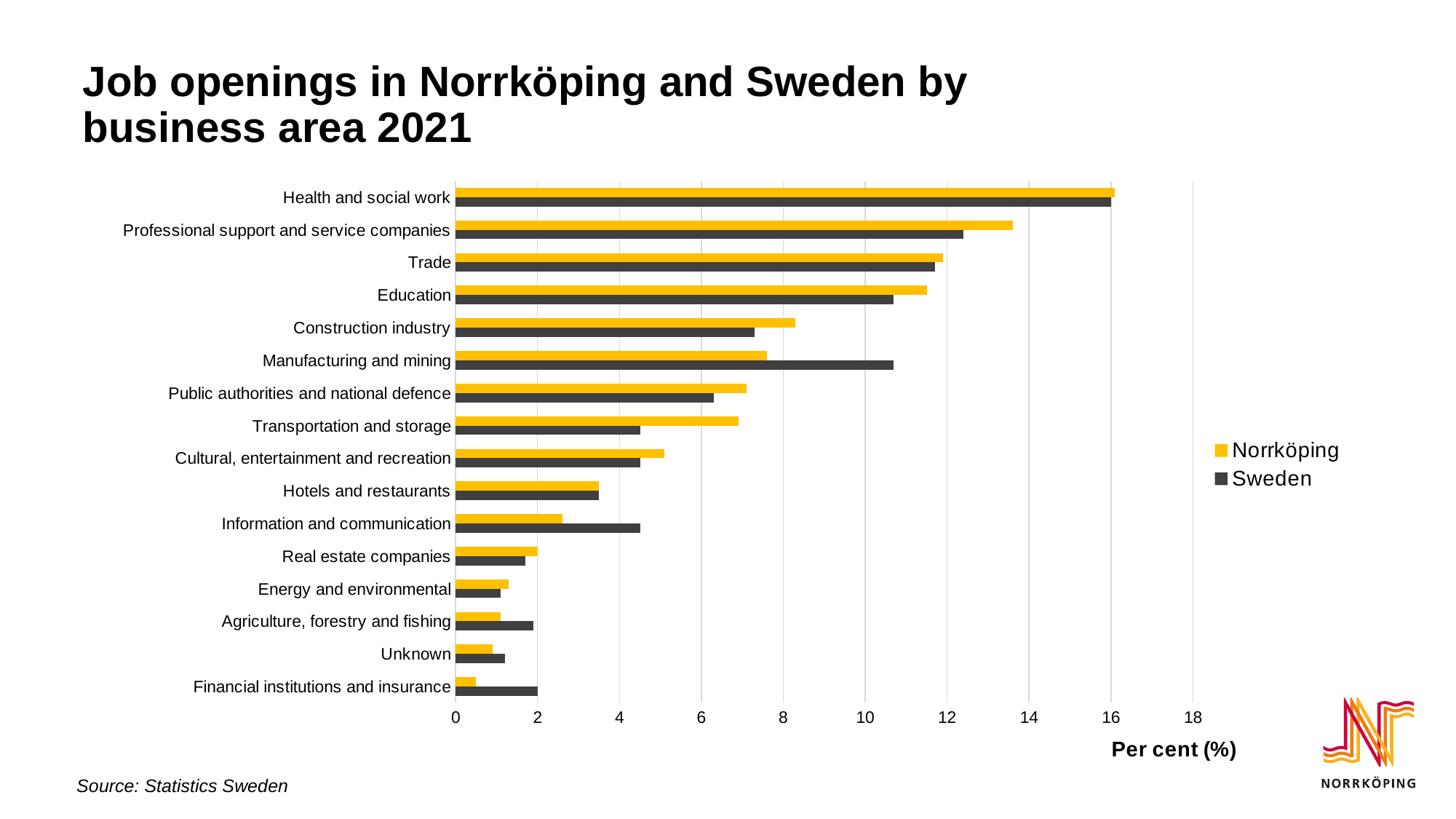
Which colour represents Sweden in the chart? Dark grey What kind of chart is shown on the slide? Bar chart For Information and communication, which is larger: the Norrköping value or the Sweden value? Sweden For Manufacturing and mining, which is larger: the Norrköping value or the Sweden value? Sweden Which business area has the highest share of job openings for Norrköping? Health and social work How many business areas are shown on the chart? 16 What is the label on the horizontal axis of the chart? Per cent (%) Is the Sweden value for Transportation and storage greater or less than 6? less For Professional support and service companies, which is larger: the Norrköping value or the Sweden value? Norrköping How many series does the legend list? 2 Is the Norrköping value for Health and social work greater or less than 14? greater Which business area has the lowest share of job openings for Norrköping? Financial institutions and insurance